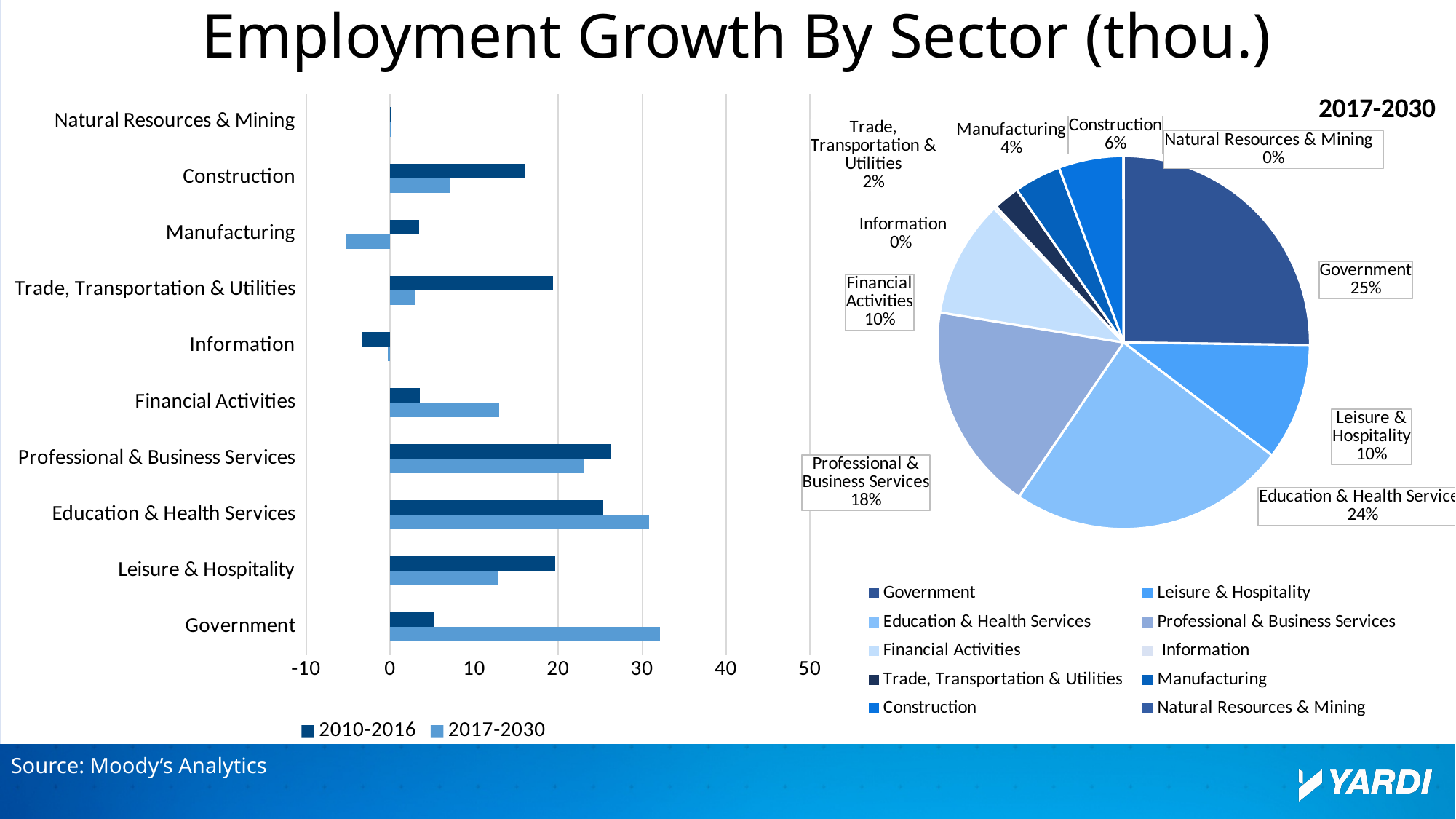
How many series does the legend of the bar chart on the left list? 2 In the pie chart on the right, what share does Government have? 25% In the pie chart on the right, what is the difference between the Government share and the Professional & Business Services share? 7% In the bar chart on the left, is the 2017-2030 value for Manufacturing greater or less than 0? less In the bar chart on the left, is the 2017-2030 value for Government greater or less than 30? greater In the pie chart on the right, what share does Manufacturing have? 4% What kind of chart is the chart on the left of the slide? Bar chart In the pie chart on the right, which sector has the largest slice? Government In the bar chart on the left, which series has the larger value for Financial Activities, 2010-2016 or 2017-2030? 2017-2030 In the bar chart on the left, which series has the larger value for Construction, 2010-2016 or 2017-2030? 2010-2016 In the pie chart on the right, what share does Professional & Business Services have? 18% How many sectors are shown in the pie chart on the right? 10